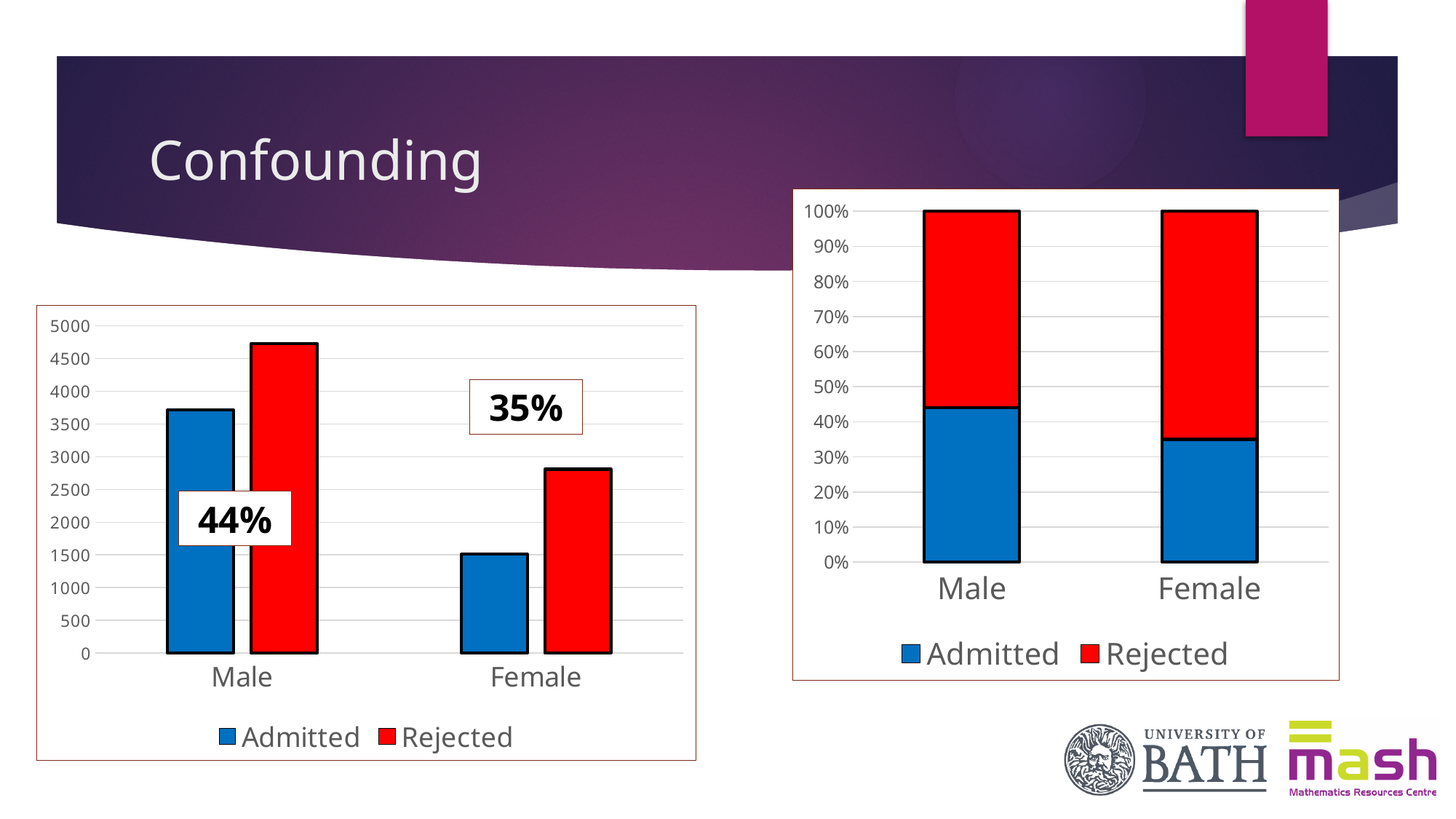
How many categories are shown on the x axis of the left chart? 2 In the left chart, is the Rejected value for Male greater or less than 4500? greater In the left chart, is the Admitted value for Female greater or less than 2000? less In the left chart, which is larger for Male: the Admitted bar or the Rejected bar? Rejected In the right chart, which category has the larger Admitted share, Male or Female? Male How many series does the legend of the left chart list? 2 In the left chart, which category has the highest Rejected bar? Male What kind of chart is the chart on the right of the slide? stacked bar chart In the right chart, is the Admitted share for Female greater or less than 40%? less What are the two series named in the legend of the right chart? Admitted and Rejected In the left chart, which category has the lowest Admitted bar? Female What kind of chart is the chart on the left of the slide? bar chart